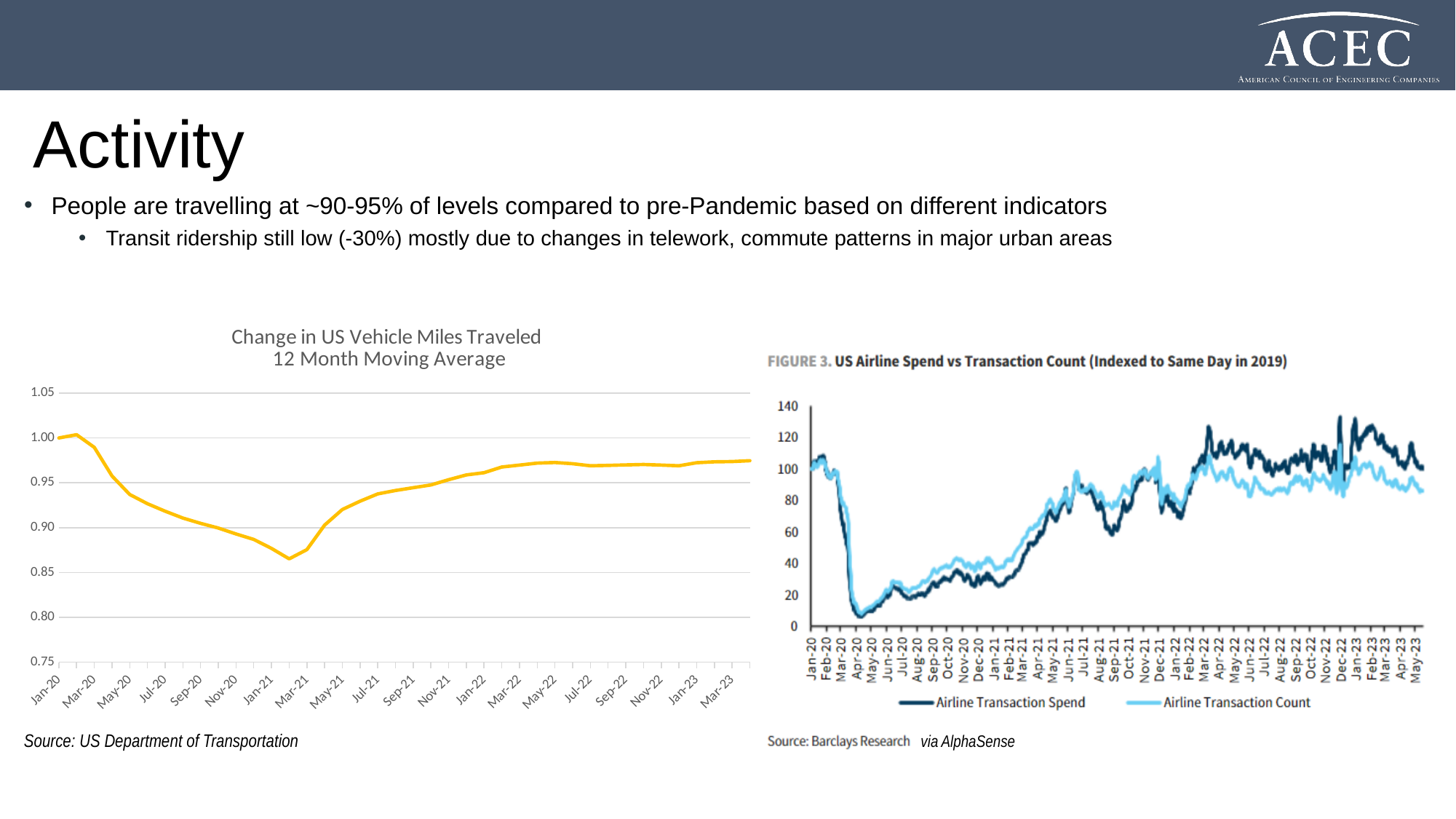
What kind of chart is the 'Change in US Vehicle Miles Traveled 12 Month Moving Average' chart on the left? line chart In the 'US Airline Spend vs Transaction Count' chart on the right, do the lines rise or fall between Apr-20 and Mar-22? rise How many series does the legend list in the 'US Airline Spend vs Transaction Count' chart on the right? 2 What are the two series named in the legend of the 'US Airline Spend vs Transaction Count' chart on the right? Airline Transaction Spend and Airline Transaction Count In the 'US Airline Spend vs Transaction Count' chart on the right, is the Airline Transaction Spend value in Apr-20 greater or less than 20? less In the 'Change in US Vehicle Miles Traveled' chart on the left, does the line rise or fall between Mar-21 and Mar-22? rise In the 'Change in US Vehicle Miles Traveled' chart on the left, does the line rise or fall between Jan-20 and Jan-21? fall In the 'Change in US Vehicle Miles Traveled' chart on the left, around which month does the line reach its lowest point? Feb-21 In the 'US Airline Spend vs Transaction Count' chart on the right, which series is higher in May-23, Airline Transaction Spend or Airline Transaction Count? Airline Transaction Spend In the 'Change in US Vehicle Miles Traveled' chart on the left, is the value for Mar-23 greater or less than 0.95? greater In the 'Change in US Vehicle Miles Traveled' chart on the left, is the value for Feb-21 greater or less than 0.90? less What is the source given for the 'Change in US Vehicle Miles Traveled' chart on the left? US Department of Transportation